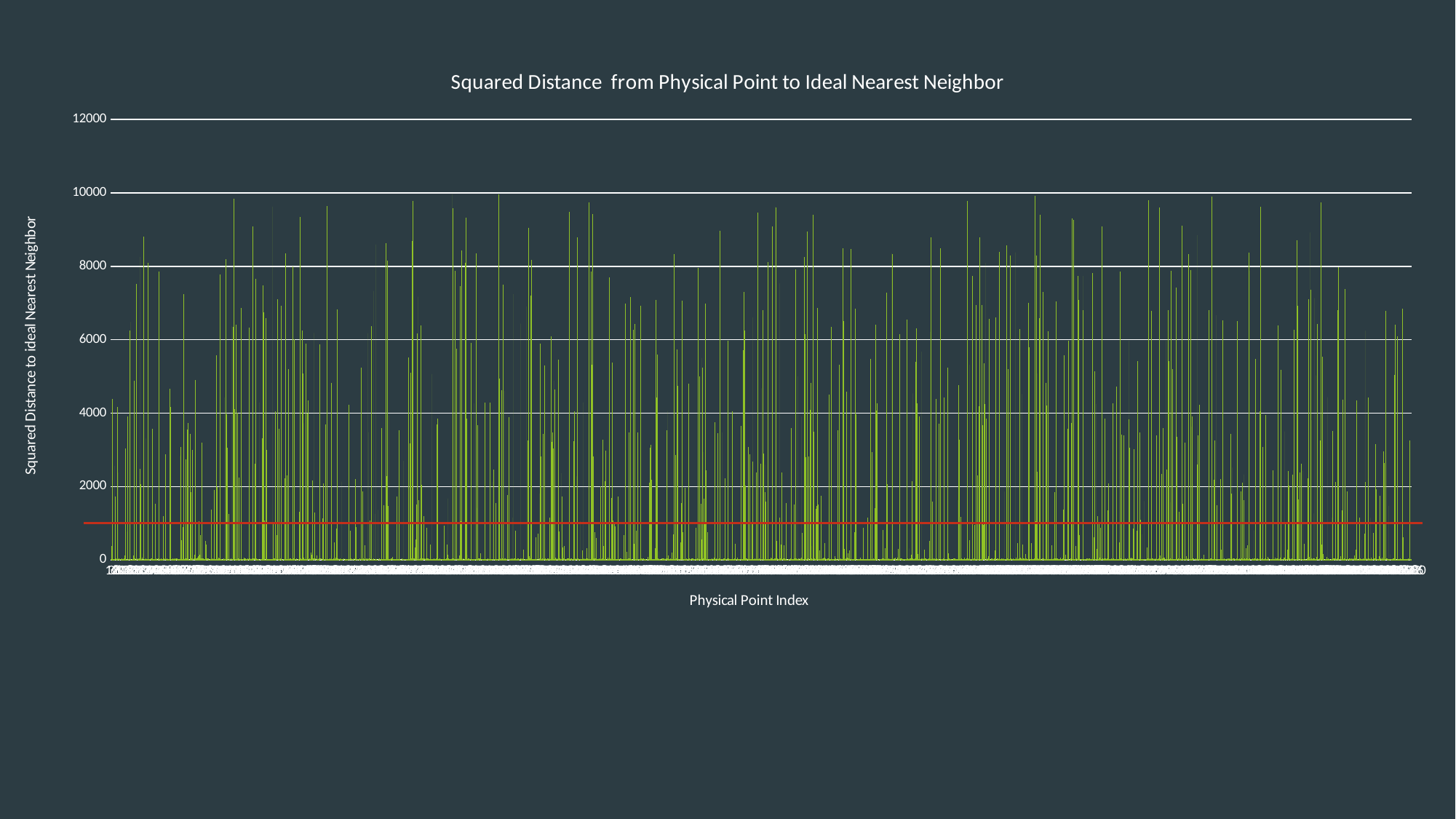
Does any bar in the chart reach a value greater than 12000? no What is the label of the x axis? Physical Point Index What is the highest value shown on the y axis? 12000 Is the tallest bar in the chart greater or less than 8000? greater What kind of chart is shown on the slide? bar chart What is the title of the chart? Squared Distance from Physical Point to Ideal Nearest Neighbor